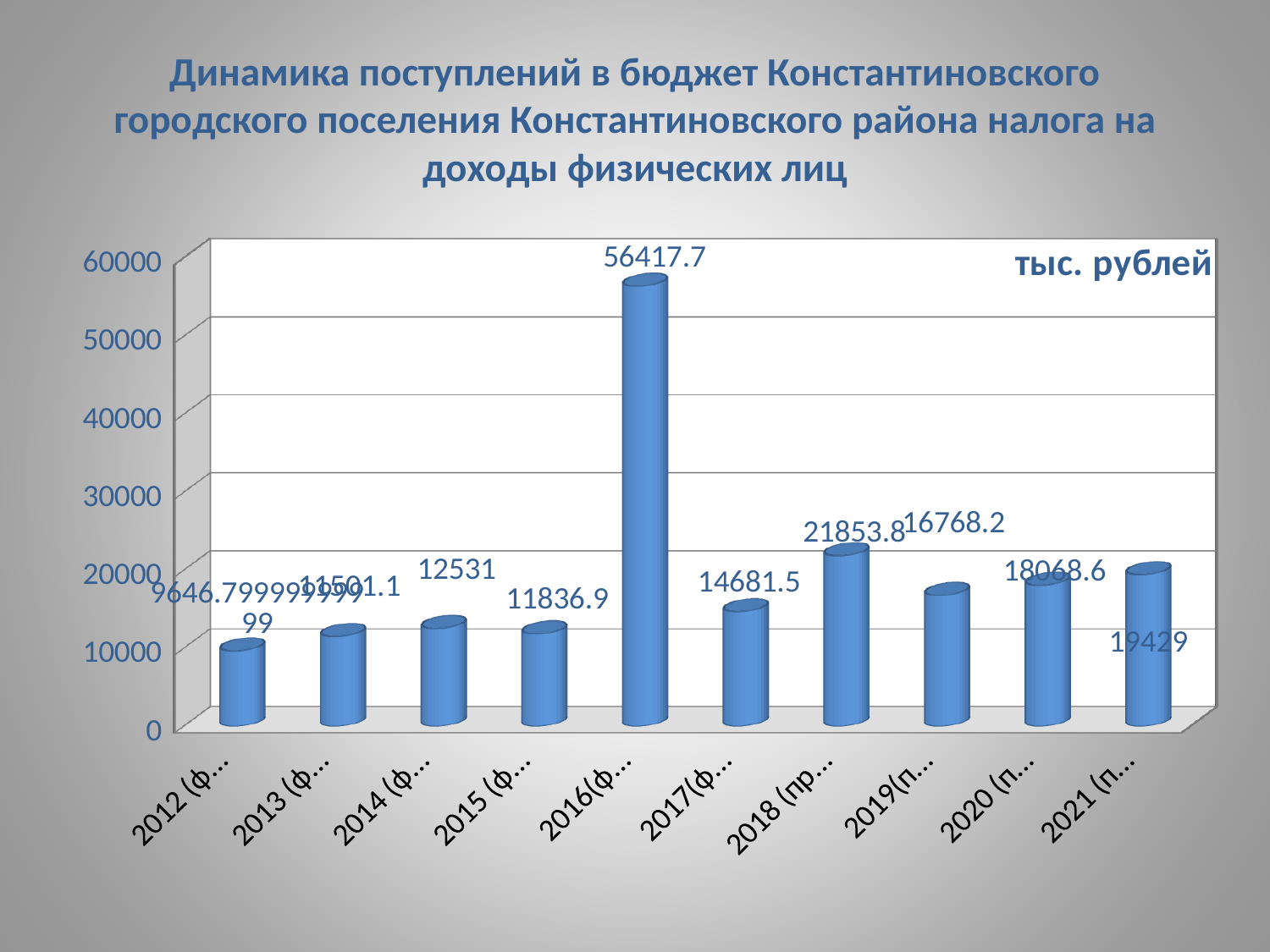
What kind of chart is shown on the slide? bar chart What is the difference between the values for 2018 and 2017? 7172.3 What is the value for 2018? 21853.8 What is the value for 2014? 12531 Is the value for 2016 greater or less than 50000? greater What is the value for 2021? 19429 What unit is indicated in the top right corner of the chart? тыс. рублей Which is larger, the value for 2020 or the value for 2019? 2020 What is the value for 2016? 56417.7 How many bars are shown in the chart? 10 Which year has the lowest value? 2012 Which year has the highest value? 2016